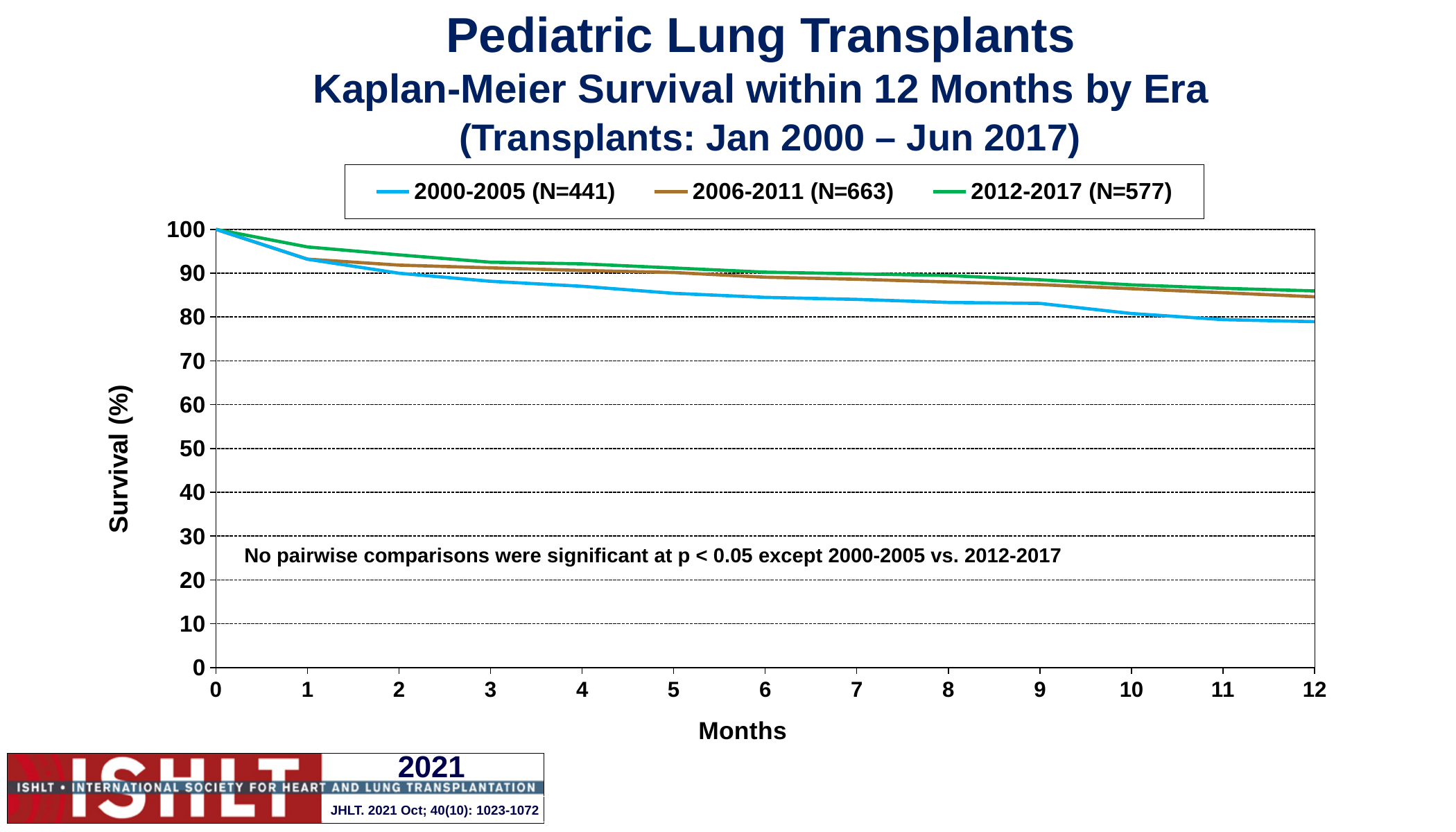
What is the label of the y axis? Survival (%) What kind of chart is shown on the slide? line chart Do the survival curves rise or fall as months increase? fall Which era has the lowest survival at 12 months? 2000-2005 (N=441) Is the survival value for the 2000-2005 era at 6 months greater or less than 90? less How many transplants (N) are in the 2006-2011 era according to the legend? 663 How many series does the legend list? 3 At 6 months, which is larger: survival for 2000-2005 or survival for 2012-2017? 2012-2017 Is the survival value for the 2000-2005 era at 12 months greater or less than 80? less What is the survival value for all three eras at month 0? 100 Which era has the highest survival at 1 month? 2012-2017 (N=577) Is the survival value for the 2012-2017 era at 12 months greater or less than 80? greater